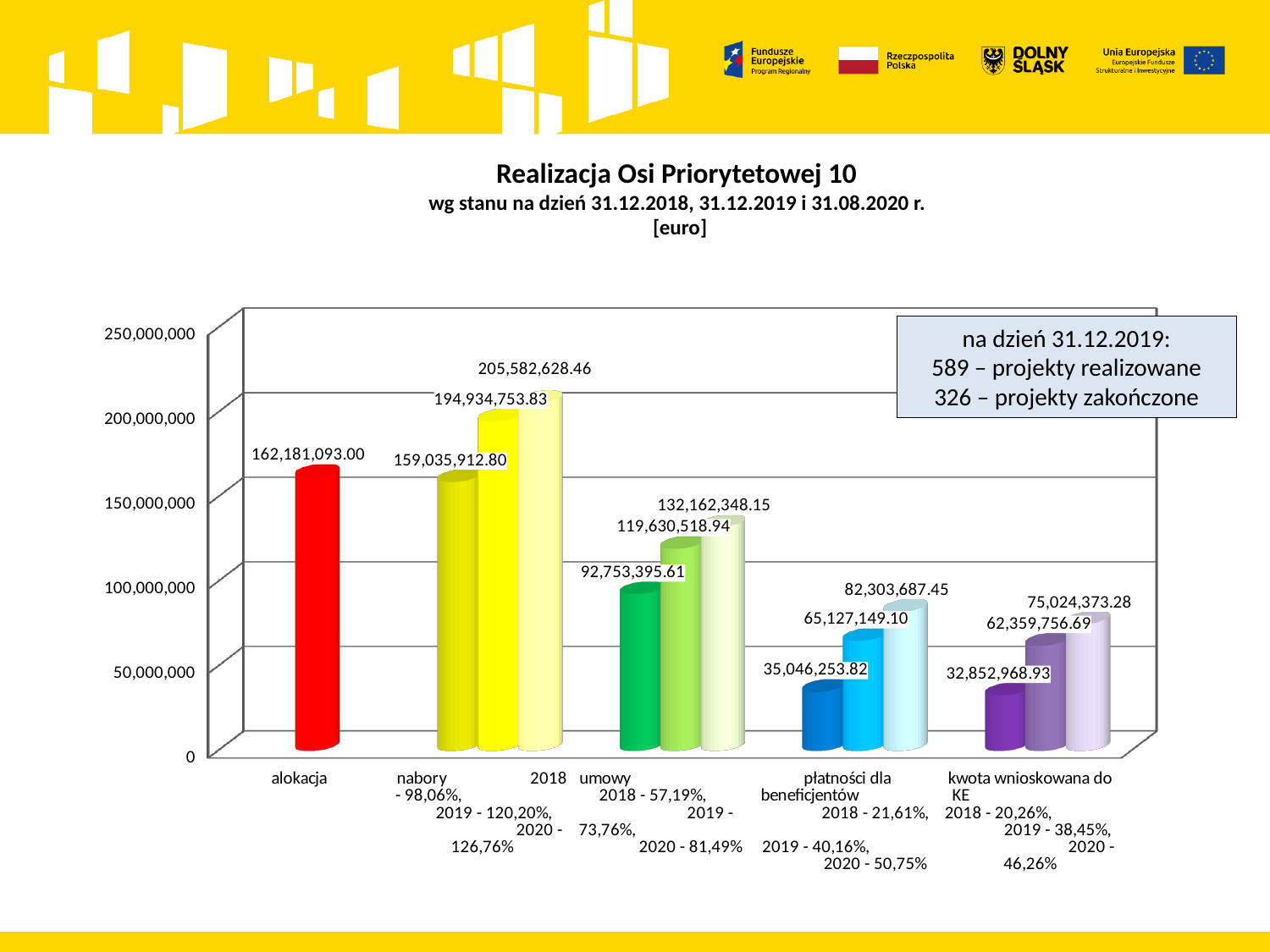
What is the value of the tallest bar in the nabory group? 205,582,628.46 What is the value of the third (rightmost) bar in the płatności dla beneficjentów group? 82,303,687.45 What is the difference between the two tallest bars in the nabory group (205,582,628.46 and 194,934,753.83)? 10,647,874.63 How many category groups are shown along the x axis? 5 Which is larger: the alokacja bar or the tallest bar in the umowy group? alokacja Which category group contains the tallest bar on the chart? nabory Within the umowy group, do the bar values rise or fall from left to right? rise What is the value shown for alokacja? 162,181,093.00 How much larger is the alokacja bar than the first (leftmost) bar in the nabory group? 3,145,180.20 Is the value for alokacja greater or less than 150,000,000? greater What is the smallest value labelled on the chart? 32,852,968.93 What kind of chart is shown on the slide? bar chart